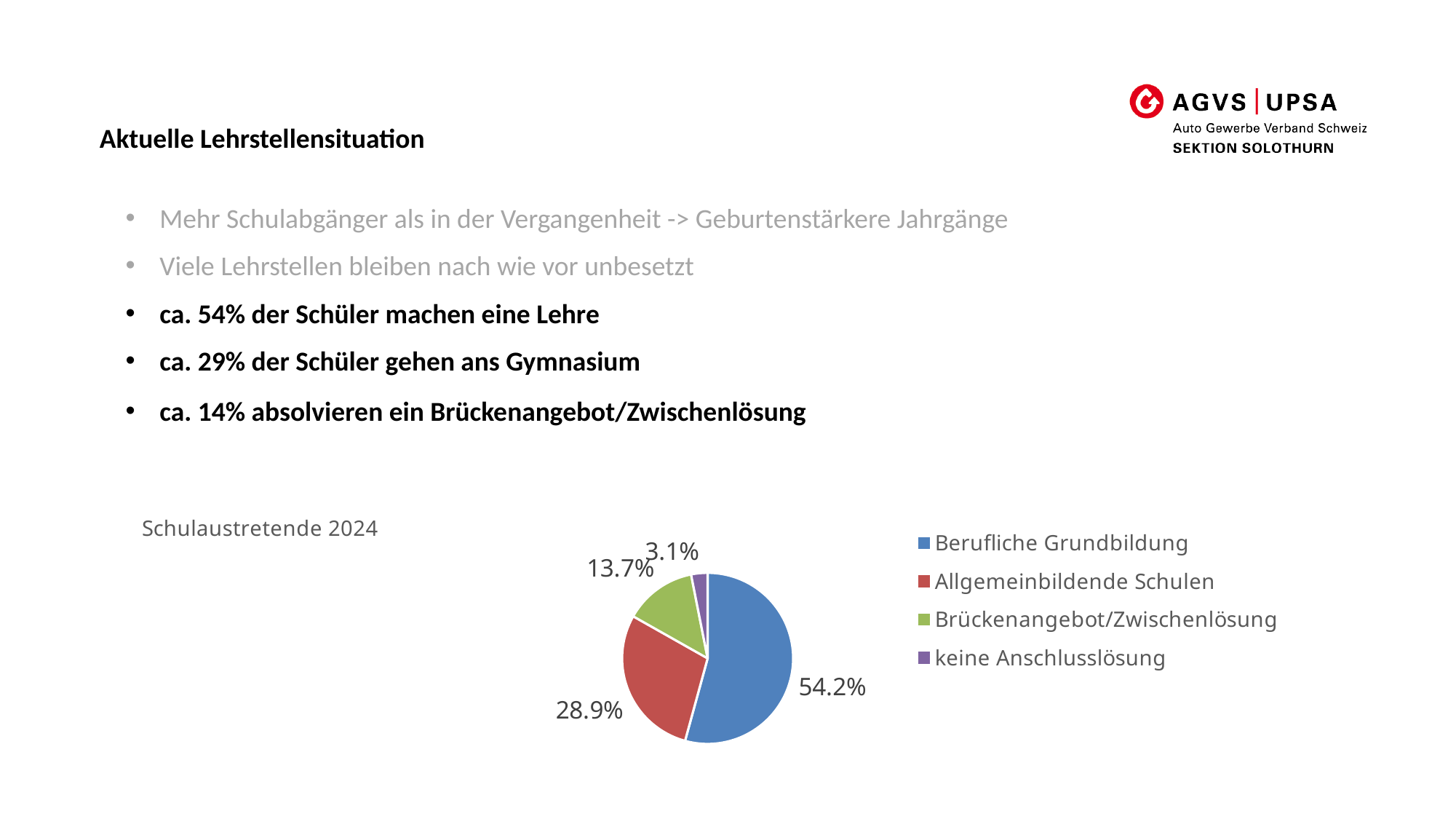
What share of the pie is Allgemeinbildende Schulen? 28.9% What share of the pie is Berufliche Grundbildung? 54.2% Which category has the largest slice of the pie? Berufliche Grundbildung What is the title of the chart? Schulaustretende 2024 Which is larger, the slice for Allgemeinbildende Schulen or the slice for Brückenangebot/Zwischenlösung? Allgemeinbildende Schulen What kind of chart is shown on the slide? pie chart How many categories does the pie chart show? 4 What share of the pie is Brückenangebot/Zwischenlösung? 13.7% What colour is the slice for Brückenangebot/Zwischenlösung? green Which category has the smallest slice of the pie? keine Anschlusslösung What share of the pie is keine Anschlusslösung? 3.1% What is the difference in percentage points between Berufliche Grundbildung and Allgemeinbildende Schulen? 25.3